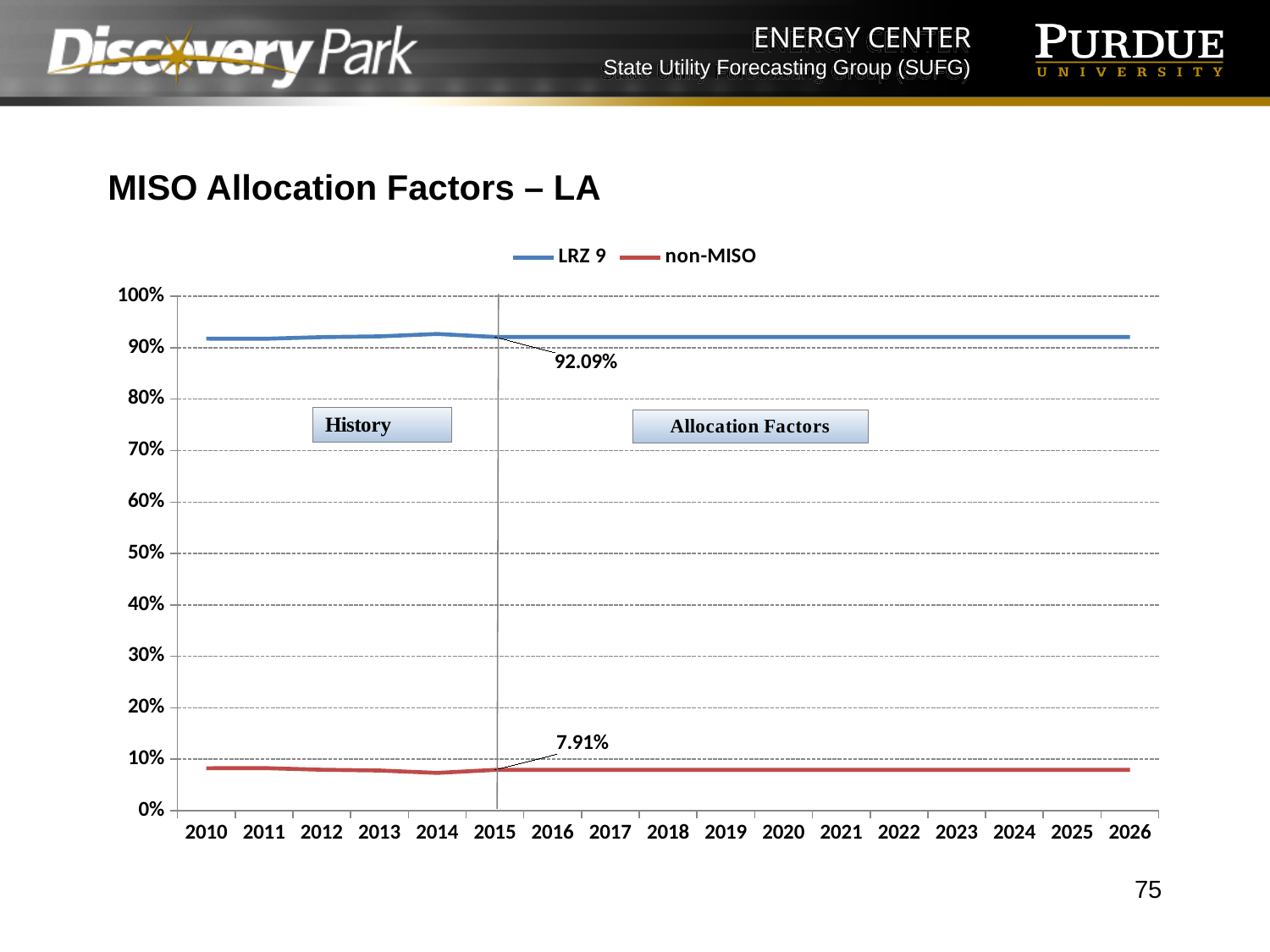
What is the title of the slide? MISO Allocation Factors – LA Is the value for LRZ 9 in 2020 greater or less than 80%? greater How many series does the legend list? 2 What is the labelled value for LRZ 9 in 2015? 92.09% What is the labelled value for non-MISO in 2015? 7.91% What is the total of the labelled LRZ 9 and non-MISO values in 2015? 100% Is the value for non-MISO in 2012 greater or less than 20%? less How many years are shown on the x axis? 17 What are the two series named in the legend? LRZ 9 and non-MISO What type of chart is shown on the slide? line chart Which series has the higher values, LRZ 9 or non-MISO? LRZ 9 What is the difference between the labelled LRZ 9 value and the labelled non-MISO value in 2015? 84.18%